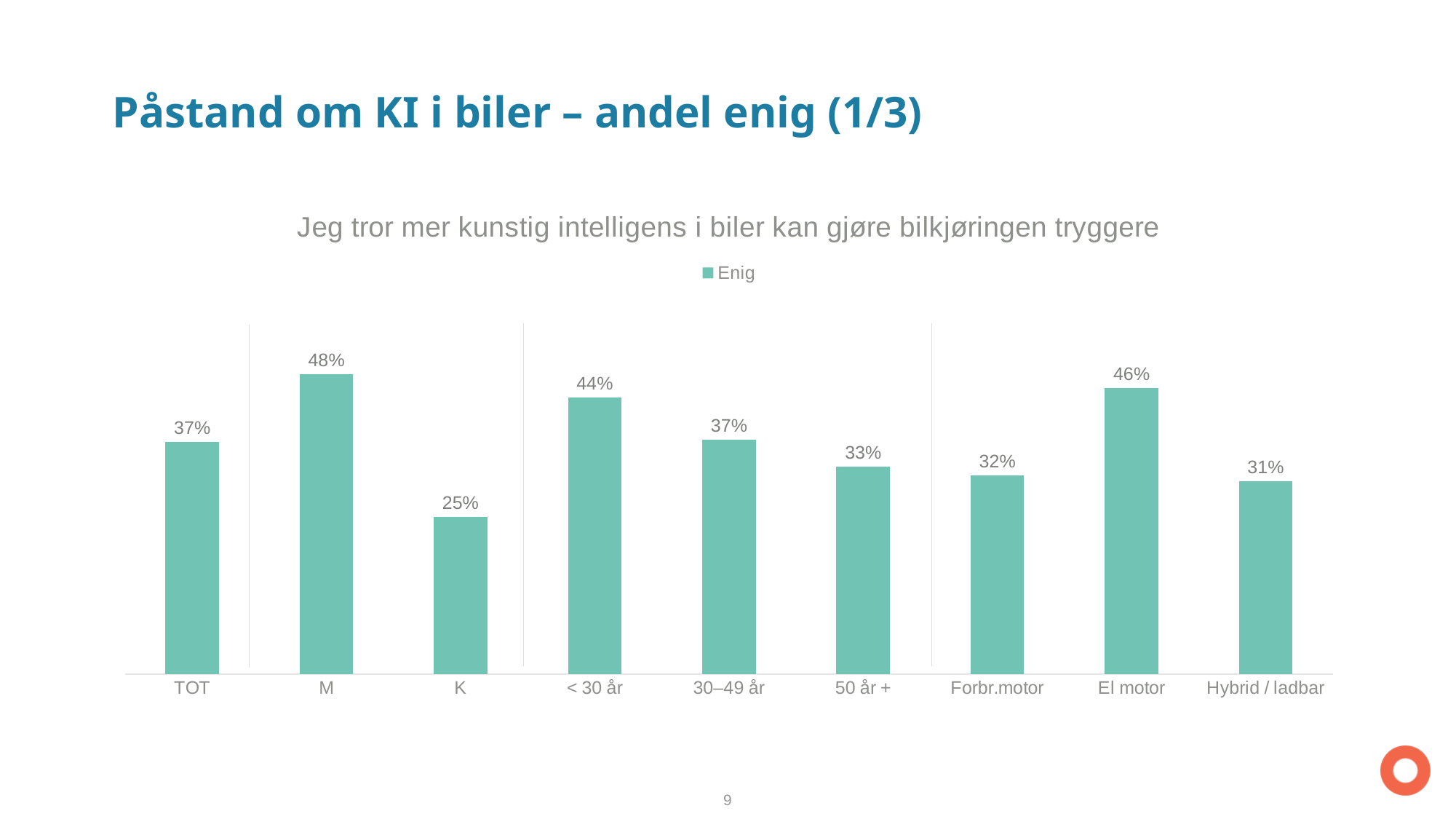
How many categories are shown on the x axis? 9 Which category has the highest value? M What is the value for K? 25% What is the value for TOT? 37% What is the chart's title? Jeg tror mer kunstig intelligens i biler kan gjøre bilkjøringen tryggere Which category has the lowest value? K What kind of chart is shown? Bar chart What is the value for 50 år +? 33% Which is larger, the value for < 30 år or the value for 30–49 år? < 30 år What is the difference between the values for M and K? 23% How many series does the legend list? 1 What is the value for El motor? 46%